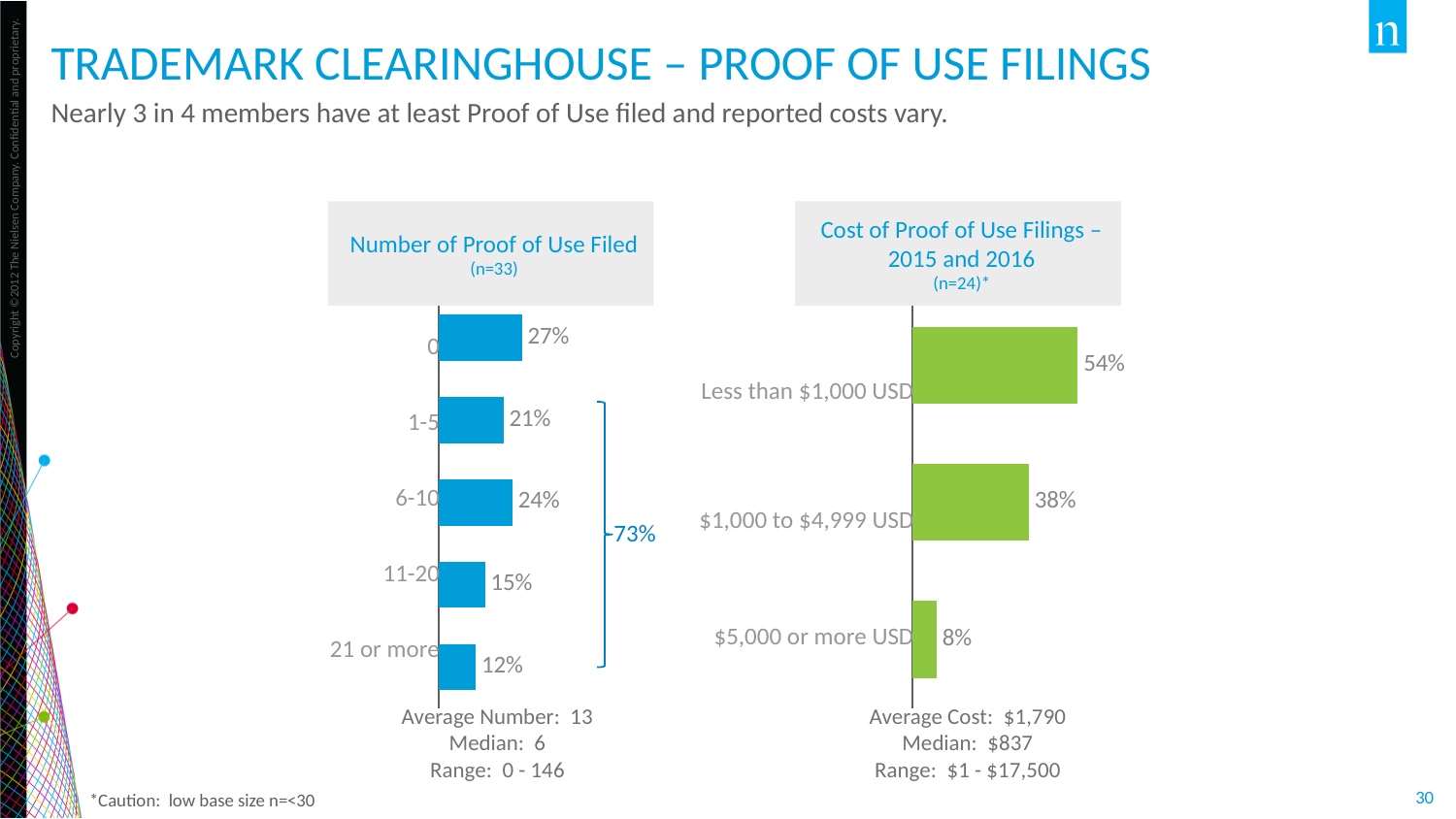
In the 'Number of Proof of Use Filed' chart, which category has the highest percentage? 0 In the 'Cost of Proof of Use Filings' chart, what is the value for '$5,000 or more USD'? 8% In the 'Number of Proof of Use Filed' chart, what is the difference between the '1-5' and '11-20' categories? 6 percentage points In the 'Cost of Proof of Use Filings' chart, what percentage reported costs of less than $1,000 USD? 54% What type of chart is the 'Cost of Proof of Use Filings' chart? Bar chart In the 'Number of Proof of Use Filed' chart, which category has the lowest percentage? 21 or more In the 'Number of Proof of Use Filed' chart, how many categories are shown? 5 In the 'Number of Proof of Use Filed' chart, what percentage of members have filed 0 Proof of Use? 27% What is the sample size (n) shown for the 'Cost of Proof of Use Filings' chart? n=24 In the 'Cost of Proof of Use Filings' chart, what is the difference between 'Less than $1,000 USD' and '$1,000 to $4,999 USD'? 16 percentage points In the 'Cost of Proof of Use Filings' chart, which category has the highest percentage? Less than $1,000 USD In the 'Number of Proof of Use Filed' chart, what is the value for the '6-10' category? 24%